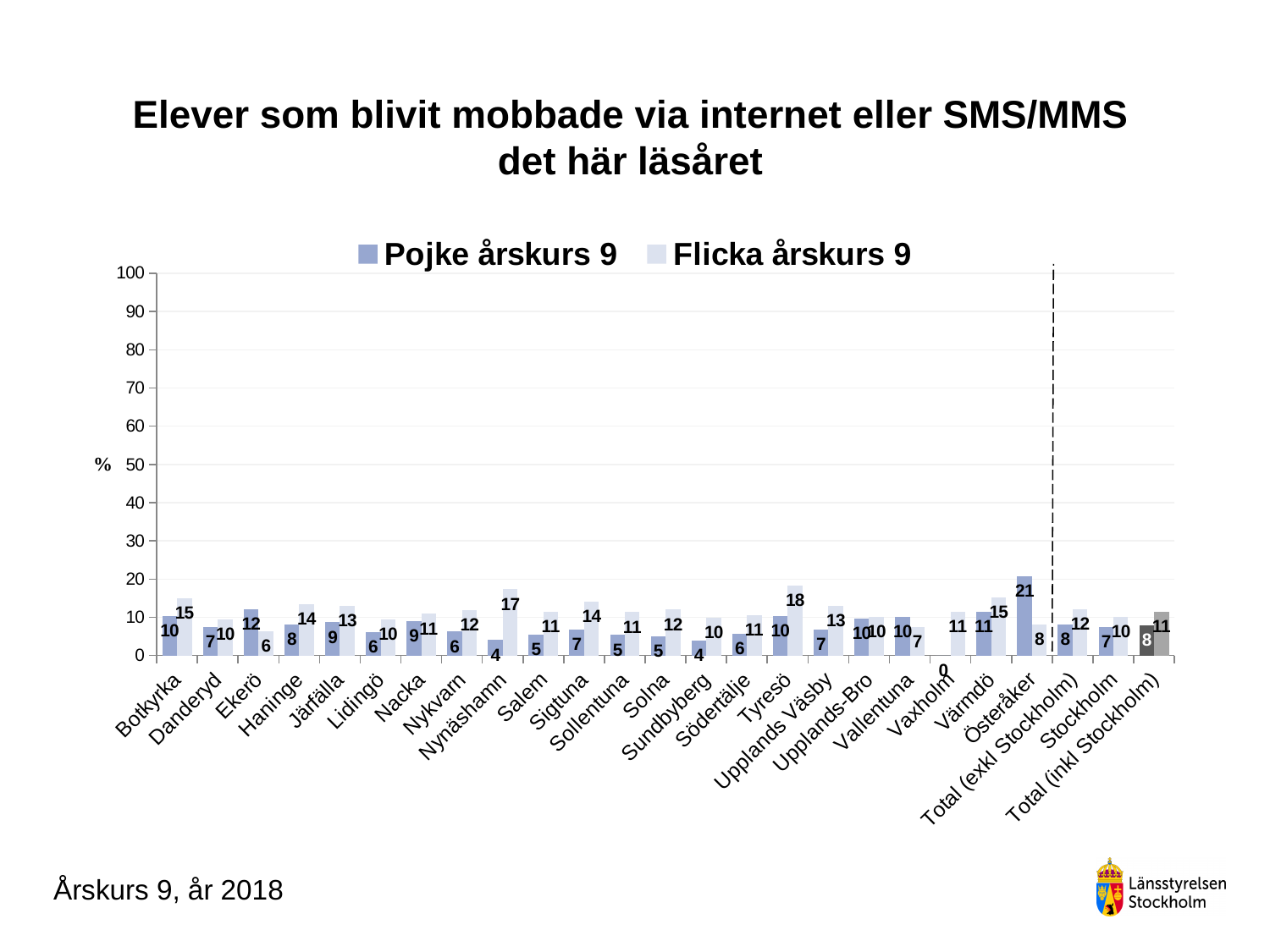
How many series does the legend list? 2 What is the value for Pojke årskurs 9 in Österåker? 21 What is the difference between Flicka årskurs 9 and Pojke årskurs 9 in Tyresö? 8 What kind of chart is shown on the slide? Bar chart What is the value for Flicka årskurs 9 in Nynäshamn? 17 Which municipality has the highest value for Flicka årskurs 9? Tyresö Which category has the highest value for Pojke årskurs 9? Österåker In Ekerö, which is larger: Pojke årskurs 9 or Flicka årskurs 9? Pojke årskurs 9 What is the title of the chart? Elever som blivit mobbade via internet eller SMS/MMS det här läsåret What is the value for Flicka årskurs 9 in Total (inkl Stockholm)? 11 Which municipality has the lowest value for Flicka årskurs 9? Ekerö Is the value for Pojke årskurs 9 in Österåker greater or less than 20? greater